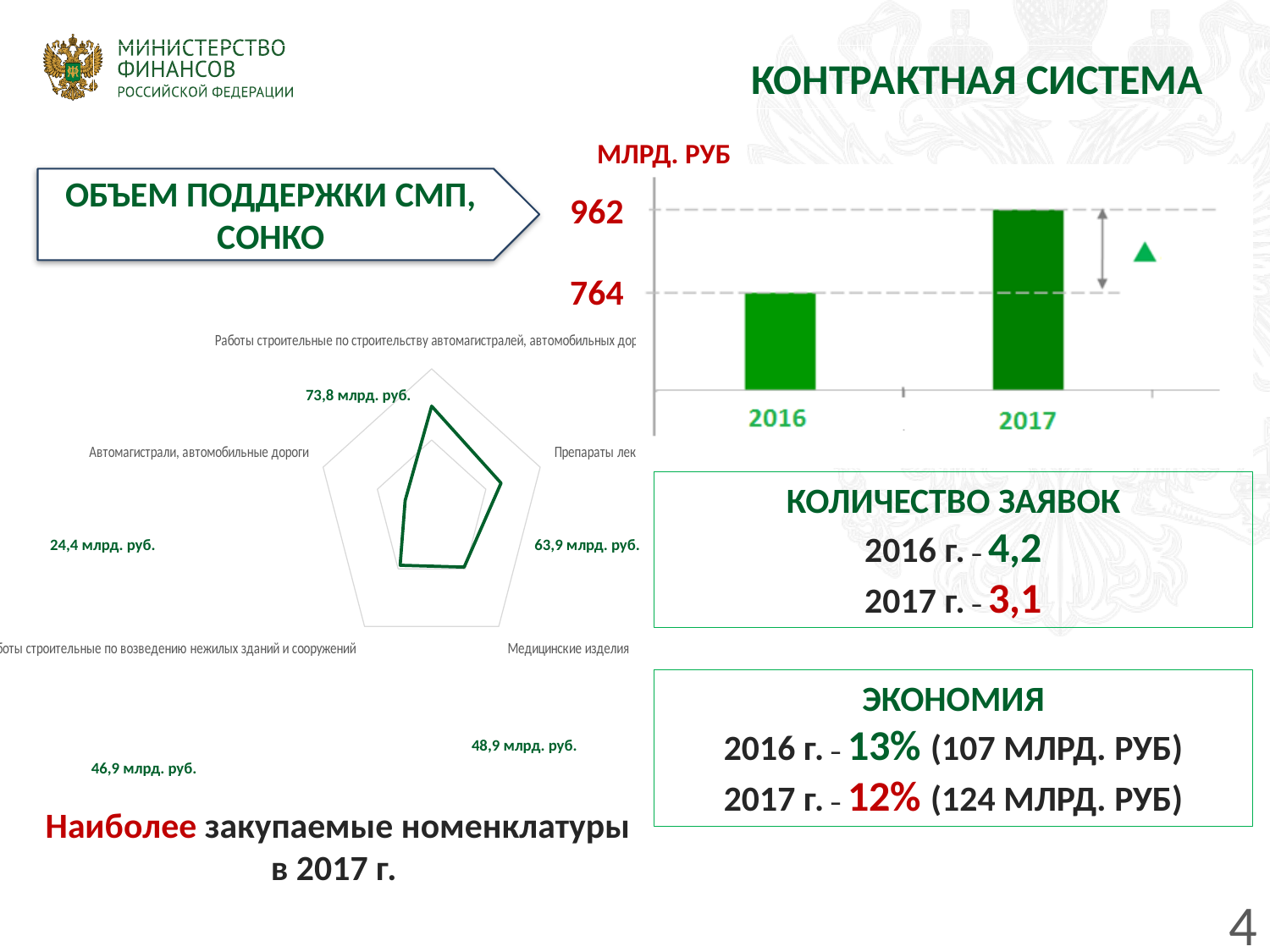
In the bar chart at the top right, which year has the higher value? 2017 In the radar chart at the bottom left, how many categories are plotted? 5 In the bar chart at the top right, what is the value for 2017? 962 What kind of chart is shown at the bottom left of the slide? radar chart In the radar chart at the bottom left, what is the value for 'Медицинские изделия'? 48,9 млрд. руб. In the bar chart at the top right, what unit is shown above the axis? МЛРД. РУБ In the radar chart at the bottom left, which category has the highest value? Работы строительные по строительству автомагистралей, автомобильных дорог In the bar chart at the top right, what is the value for 2016? 764 In the radar chart at the bottom left, what is the value for 'Автомагистрали, автомобильные дороги'? 24,4 млрд. руб. What kind of chart is shown at the top right of the slide? bar chart In the bar chart at the top right, by how much does the 2017 value exceed the 2016 value? 198 In the bar chart at the top right, do the values rise or fall from 2016 to 2017? rise